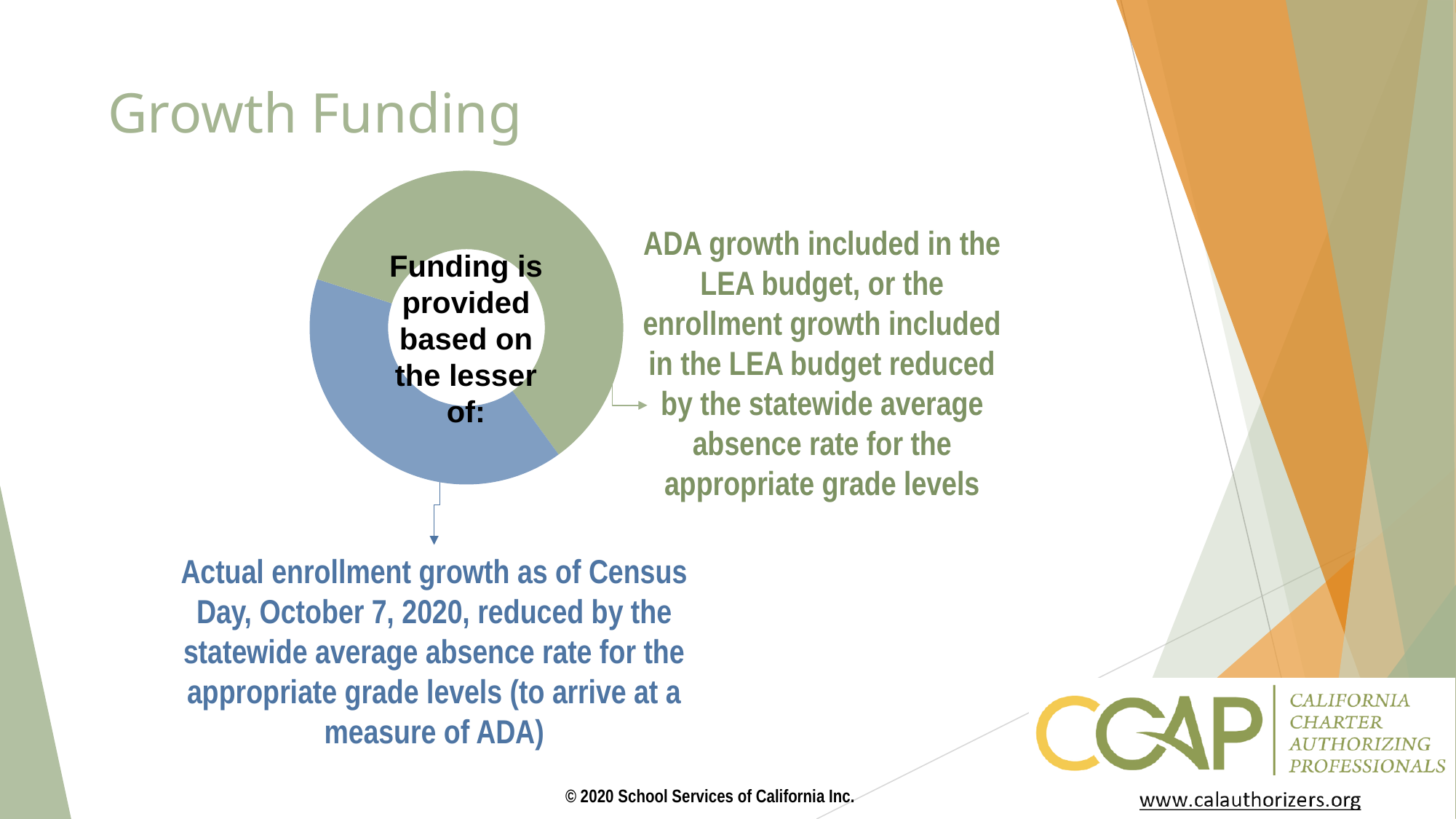
Which segment of the doughnut chart is the smallest? The blue segment How many segments does the doughnut chart have? 2 Which segment of the doughnut chart is larger, the green one or the blue one? The green one What colour is the segment of the doughnut chart that points to the text about actual enrollment growth as of Census Day? Blue What kind of chart is shown on the slide? Doughnut chart What text is printed in the centre of the doughnut chart? Funding is provided based on the lesser of: